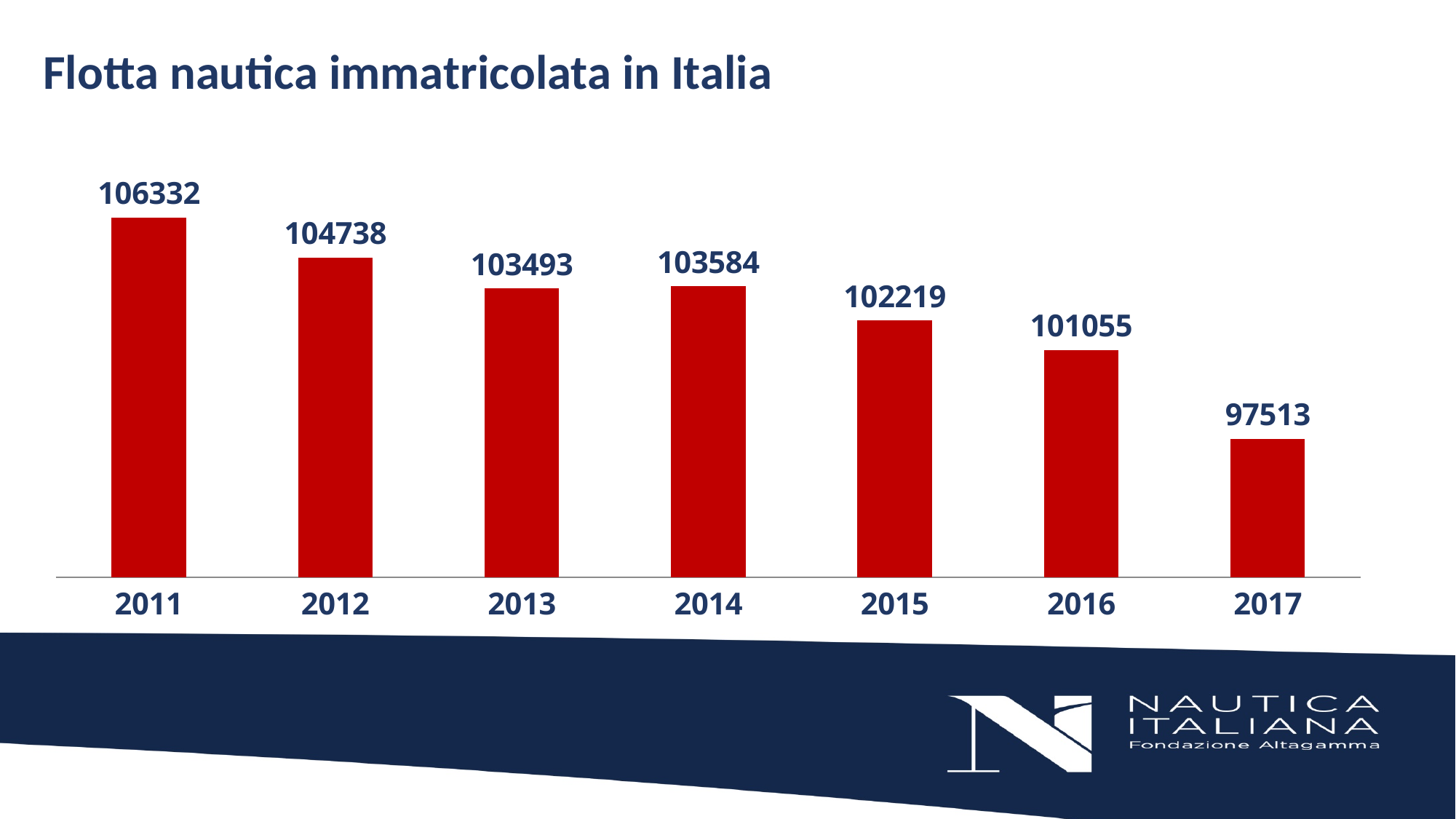
What is the difference between the values for 2011 and 2017? 8819 What is the value for 2017? 97513 What is the value for 2011? 106332 What is the title of the chart? Flotta nautica immatricolata in Italia What kind of chart is shown on the slide? bar chart What is the value for 2014? 103584 What is the difference between the values for 2015 and 2016? 1164 Which year has the lowest value? 2017 Do the values generally rise or fall from 2011 to 2017? fall Which is larger, the value for 2013 or the value for 2014? 2014 How many years are shown on the chart? 7 Which year has the highest value? 2011